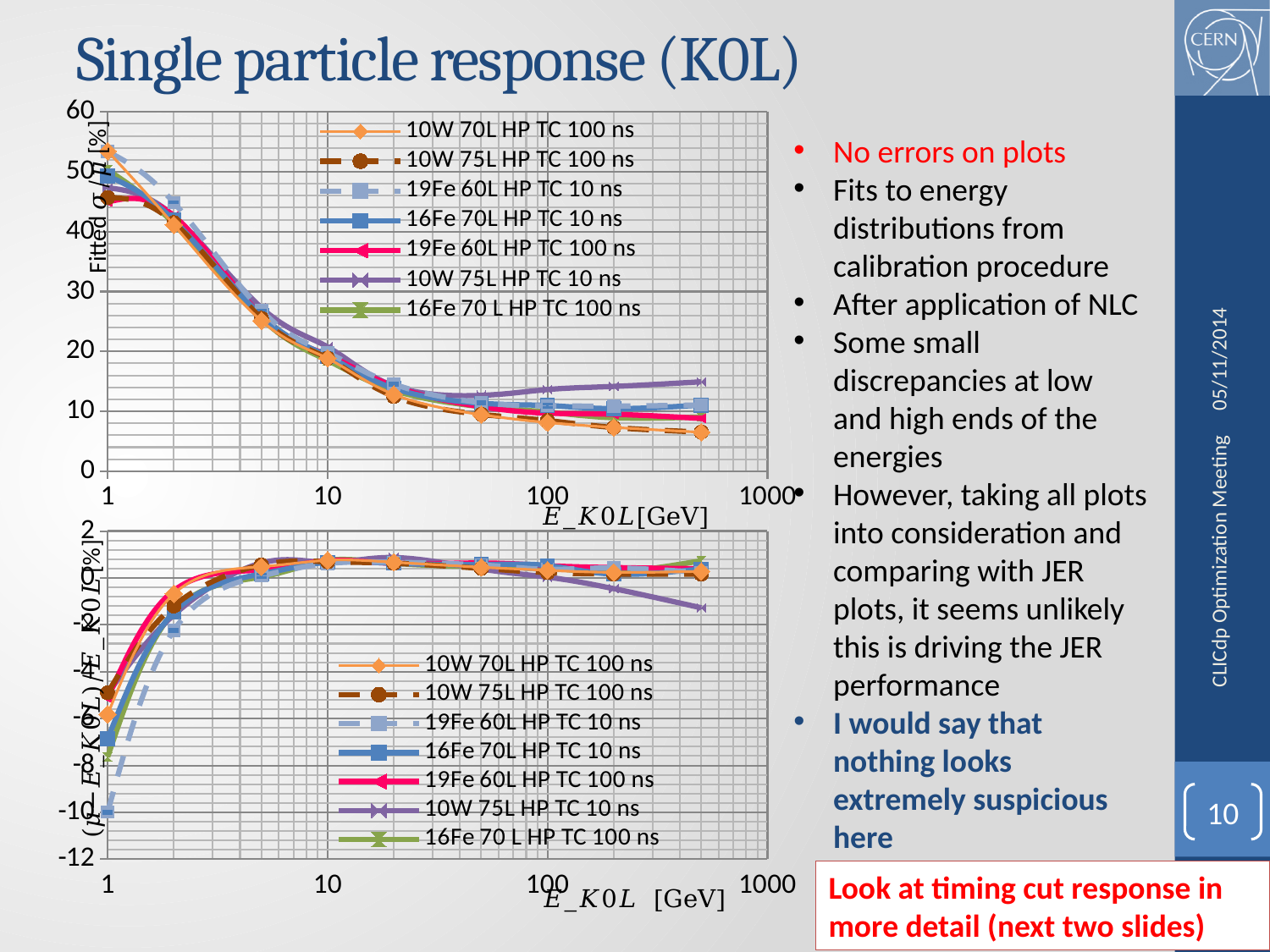
How many series does the legend of the top chart list? 7 What is the x-axis label of the top chart? E_K0L [GeV] In the top chart, do the values generally rise or fall as E_K0L increases from 1 to 100 GeV? fall In the top chart, is the value for 10W 75L HP TC 100 ns at 100 GeV greater or less than 20? less In the top chart, at the rightmost energy point, which is larger: 10W 75L HP TC 10 ns or 10W 70L HP TC 100 ns? 10W 75L HP TC 10 ns In the bottom chart, which series has the lowest value at the rightmost energy point (around 500 GeV)? 10W 75L HP TC 10 ns In the bottom chart, is the value for 10W 75L HP TC 100 ns at 10 GeV greater or less than -2? greater In the top chart, is the value for 10W 70L HP TC 100 ns at 1 GeV greater or less than 40? greater What kind of chart is the top chart on the slide? line chart How many series does the legend of the bottom chart list? 7 In the top chart, which series has the highest value at the rightmost energy point (around 500 GeV)? 10W 75L HP TC 10 ns